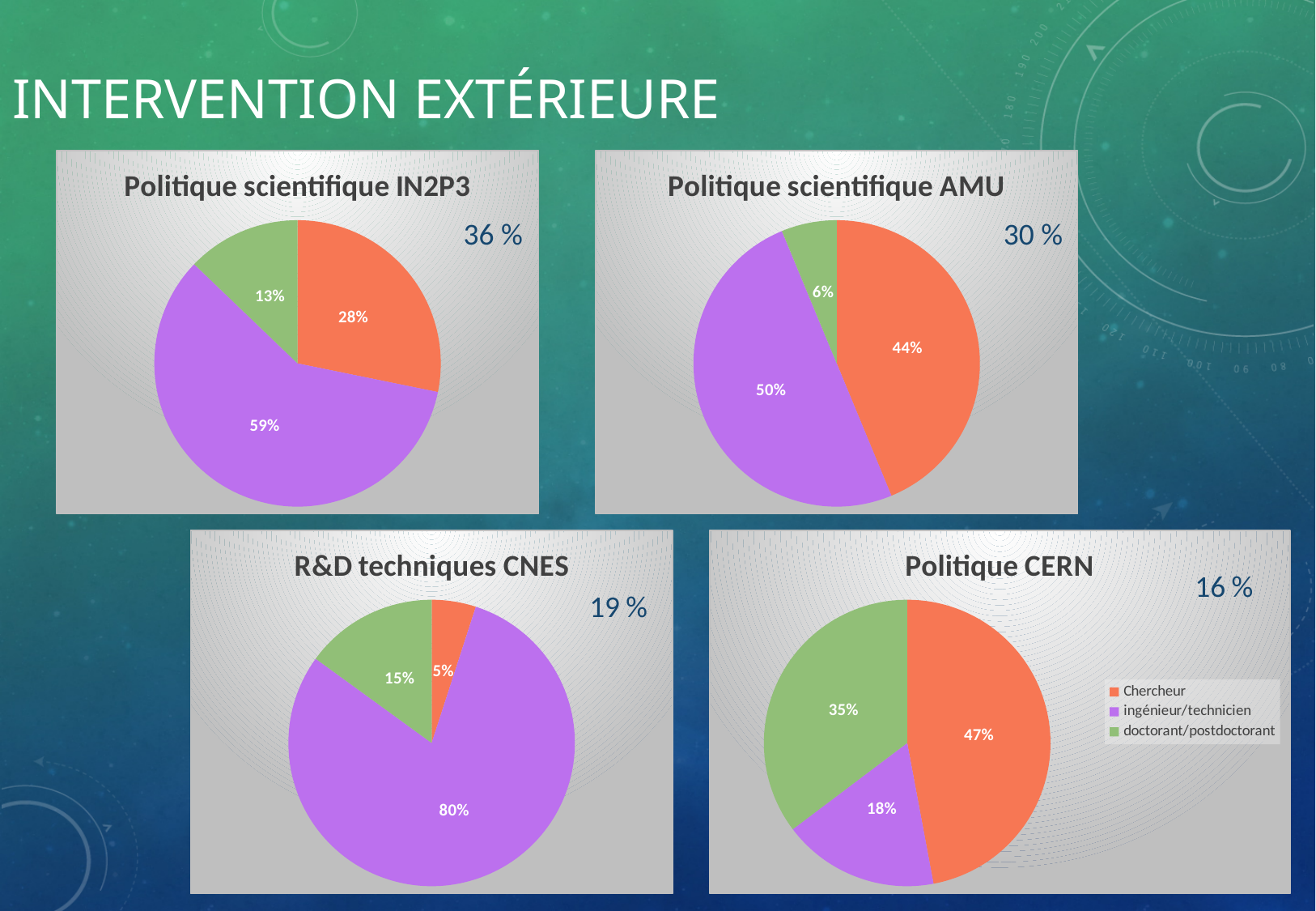
In the 'Politique scientifique AMU' chart, which slice is larger, the orange one or the purple one? the purple one In the 'Politique CERN' chart, what share is labelled for ingénieur/technicien? 18% In the 'Politique scientifique AMU' chart, what percentage is shown on the green slice? 6% How many entries does the legend on the 'Politique CERN' chart list? 3 In the 'Politique CERN' chart, which category has the smallest slice? ingénieur/technicien In the 'R&D techniques CNES' chart, what is the difference between the green slice and the orange slice? 10% In the 'Politique CERN' chart, what share is labelled for Chercheur? 47% What type of chart is used for 'Politique scientifique IN2P3'? pie chart In the 'R&D techniques CNES' chart, what percentage is shown on the purple slice? 80% In the 'Politique scientifique IN2P3' chart, what percentage is shown on the purple slice? 59% How many slices does the 'Politique CERN' pie chart have? 3 In the 'Politique scientifique IN2P3' chart, what is the difference between the orange slice and the green slice? 15%